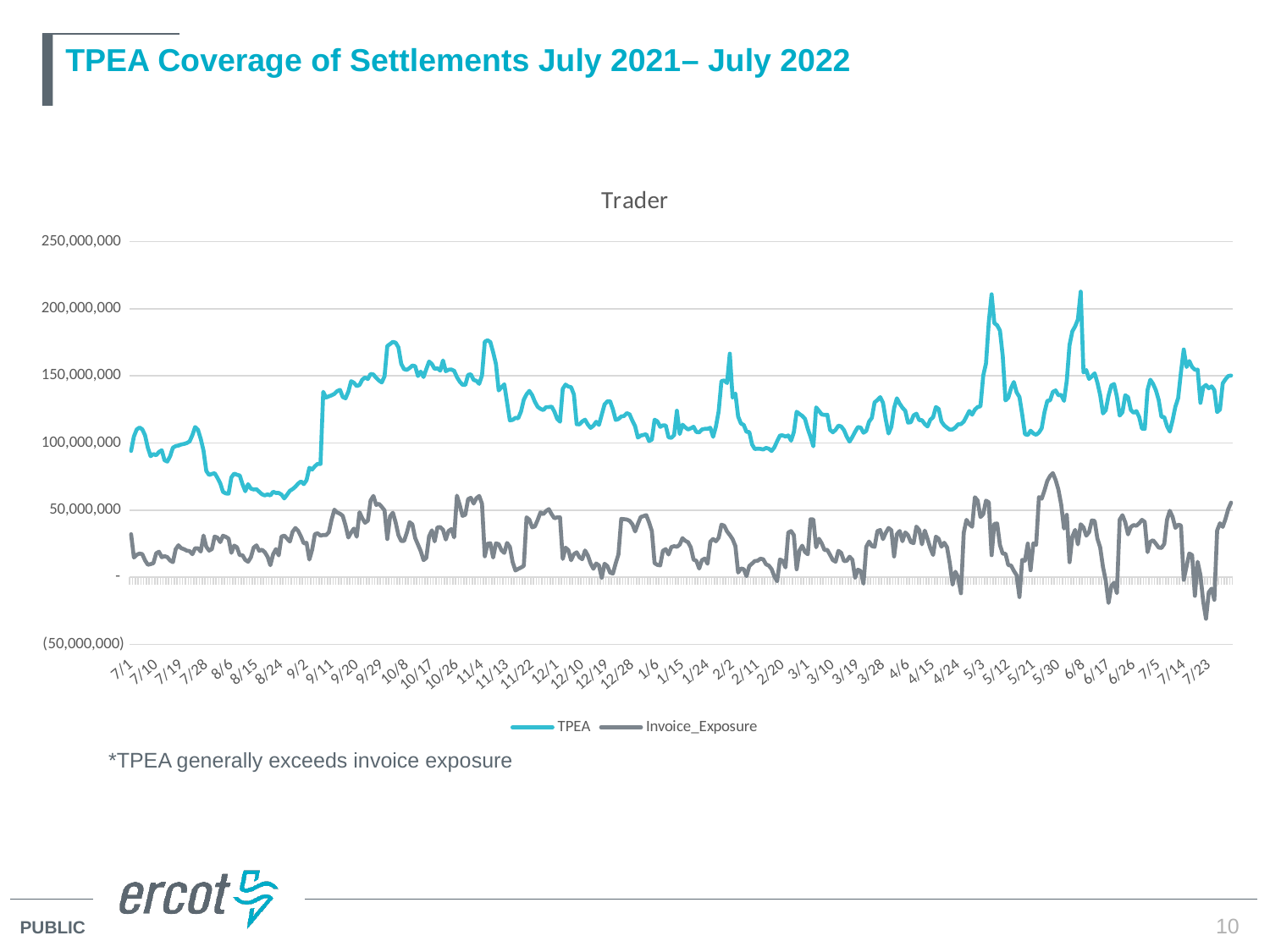
Is the TPEA value around 8/15 greater or less than 100,000,000? less Is the Invoice_Exposure value around 5/30 greater or less than 100,000,000? less Does the TPEA line rise or fall between 8/24 and 9/20? rise What kind of chart is shown on the slide? line chart Is the peak TPEA value around 5/3 greater or less than 200,000,000? greater Which series has the lowest value on the chart? Invoice_Exposure How many series does the legend list? 2 Around 9/20, which series is higher, TPEA or Invoice_Exposure? TPEA Which series reaches the highest value on the chart? TPEA Which two series are listed in the legend? TPEA and Invoice_Exposure What is the title printed above the chart? Trader